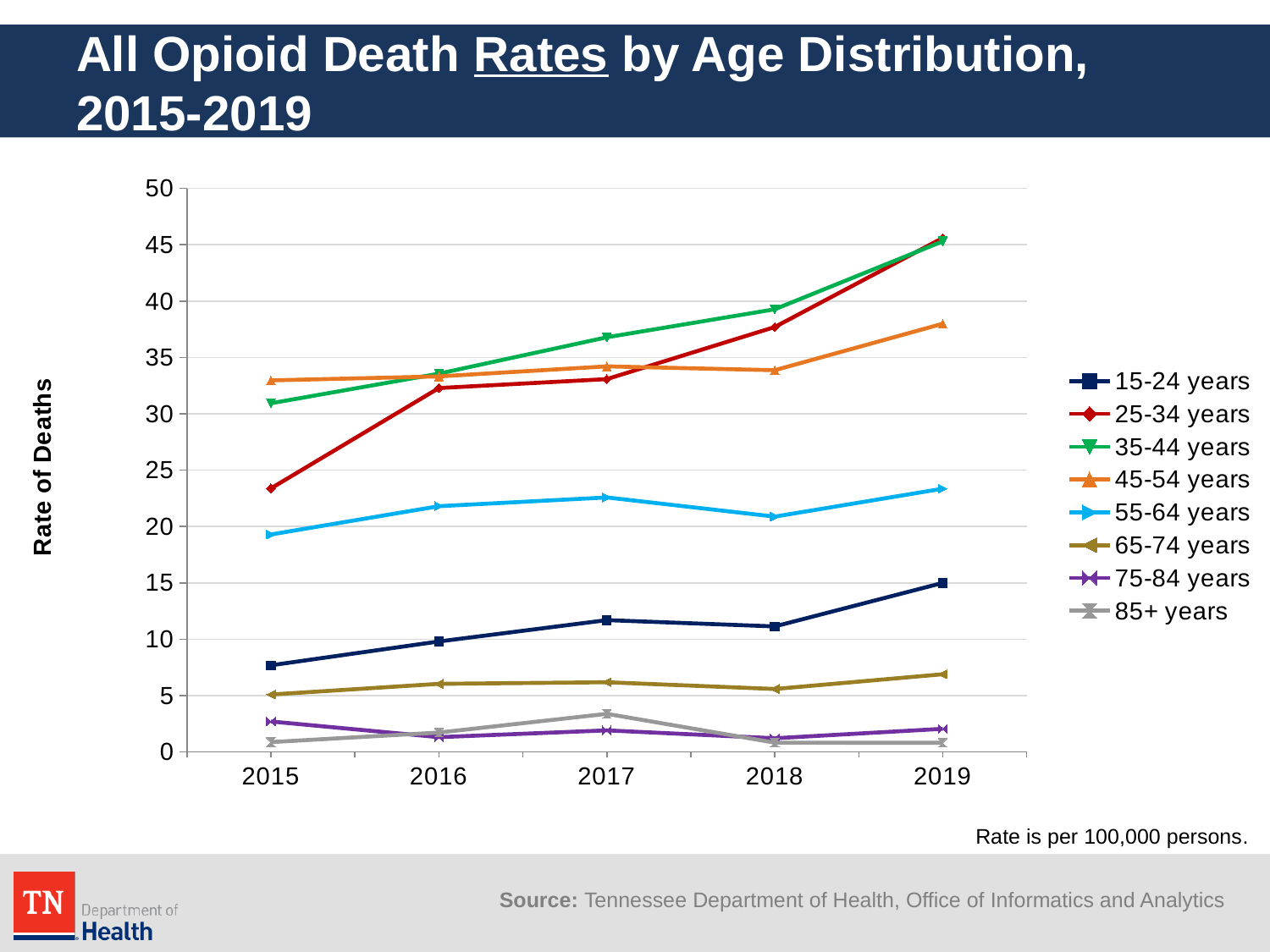
Is the value for 25-34 years in 2015 greater or less than 25? less Is the value for 45-54 years in 2019 greater or less than 35? greater In 2015, which has the larger rate: 25-34 years or 55-64 years? 25-34 years Which age group has the highest opioid death rate in 2018? 35-44 years How many years are plotted along the x axis? 5 Which age group has the lowest opioid death rate in 2015? 85+ years Which age group has the lowest opioid death rate in 2019? 85+ years What type of chart is shown on the slide? line chart Is the value for 15-24 years in 2019 greater or less than 10? greater What is the title of the y axis? Rate of Deaths How many age groups does the legend list? 8 Does the rate for 35-44 years rise or fall from 2015 to 2019? rise